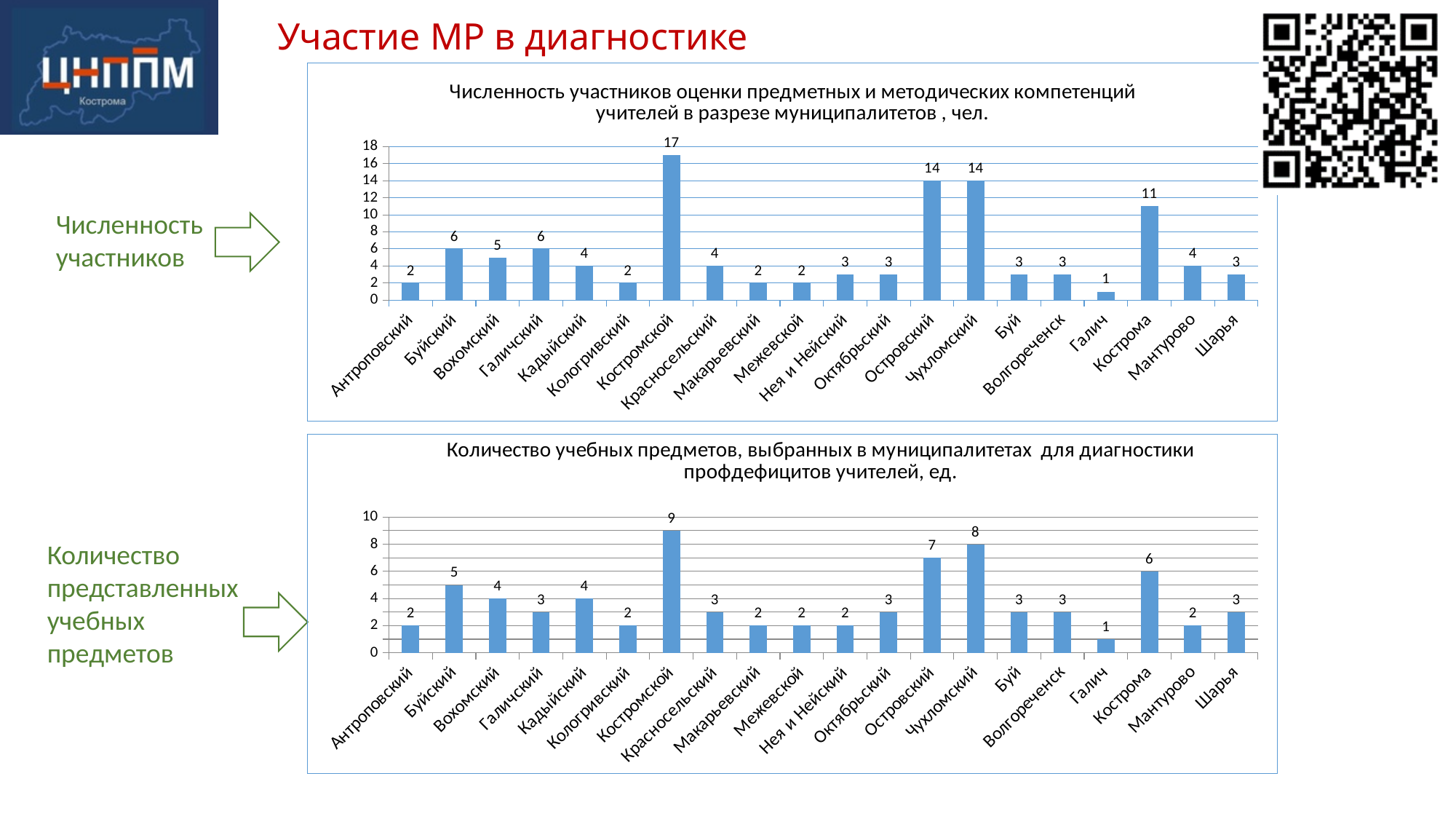
In the top chart (Численность участников оценки...), which municipality has the lowest value? Галич In the bottom chart (Количество учебных предметов...), which municipality has the highest value? Костромской In the bottom chart (Количество учебных предметов...), which is larger, the value for Островский or the value for Кострома? Островский In the top chart (Численность участников оценки...), what is the difference between the values for Костромской and Кострома? 6 In the bottom chart (Количество учебных предметов...), what is the value for Чухломский? 8 In the top chart (Численность участников оценки...), which municipality has the highest value? Костромской In the top chart (Численность участников оценки...), what is the value for Островский? 14 In the bottom chart (Количество учебных предметов...), what is the value for Галич? 1 In the top chart (Численность участников оценки...), how many municipalities are shown on the x axis? 20 In the top chart (Численность участников оценки...), what is the value for Костромской? 17 What type of chart is the bottom chart (Количество учебных предметов...)? Bar chart In the bottom chart (Количество учебных предметов...), what is the difference between the values for Костромской and Чухломский? 1